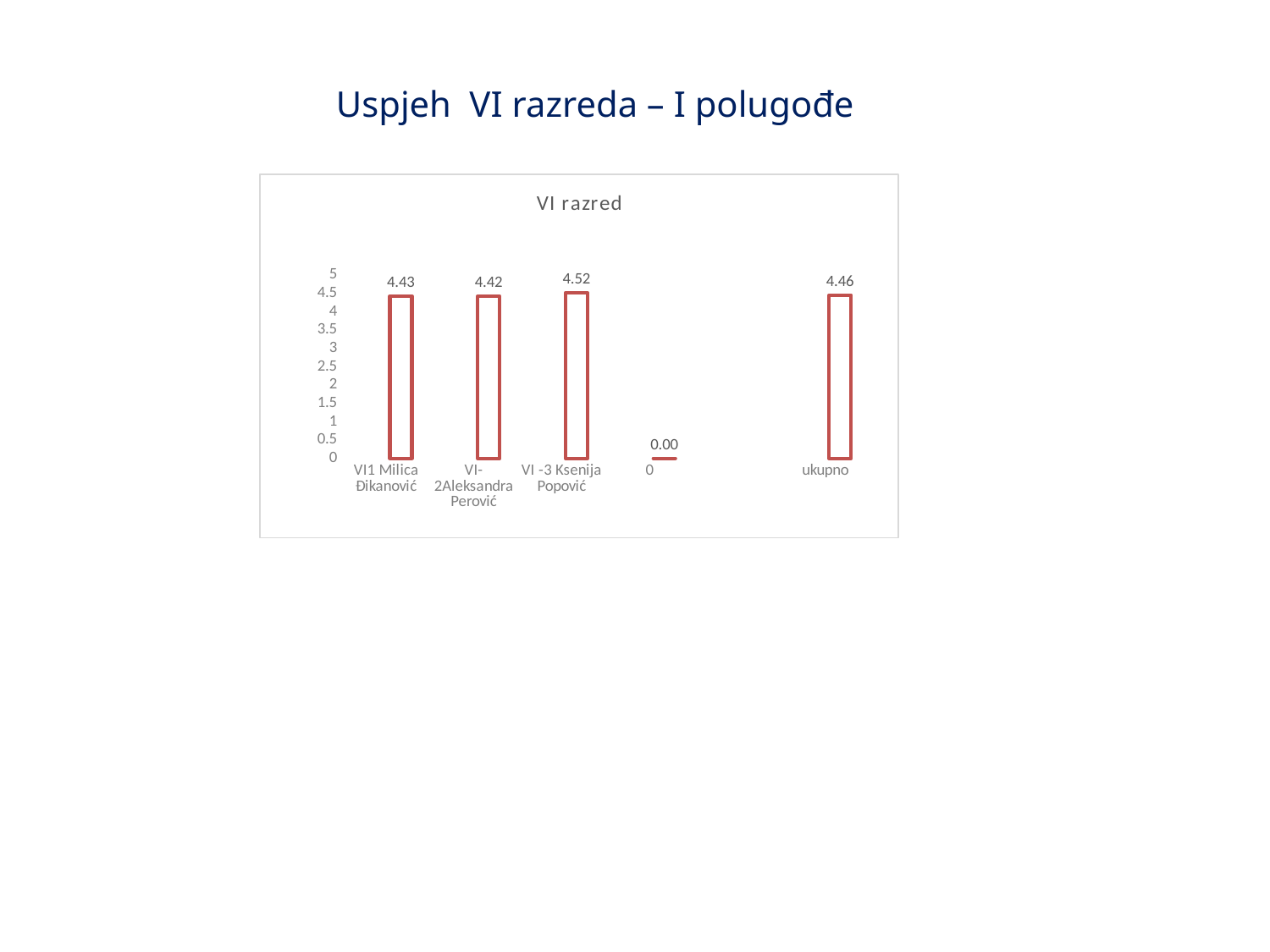
Which is larger, the value for VI -3 Ksenija Popović or the value for VI1 Milica Đikanović? VI -3 Ksenija Popović What is the value for VI1 Milica Đikanović? 4.43 What is the value for VI-2Aleksandra Perović? 4.42 What is the difference between the values for VI -3 Ksenija Popović and VI-2Aleksandra Perović? 0.10 Is the value for ukupno greater or less than 4? greater What is the value for VI -3 Ksenija Popović? 4.52 How many categories are shown on the x axis? 5 What is the title of the chart? VI razred What kind of chart is shown on the slide? bar chart Which category has the lowest value? 0 What is the value for ukupno? 4.46 Which category has the highest value? VI -3 Ksenija Popović